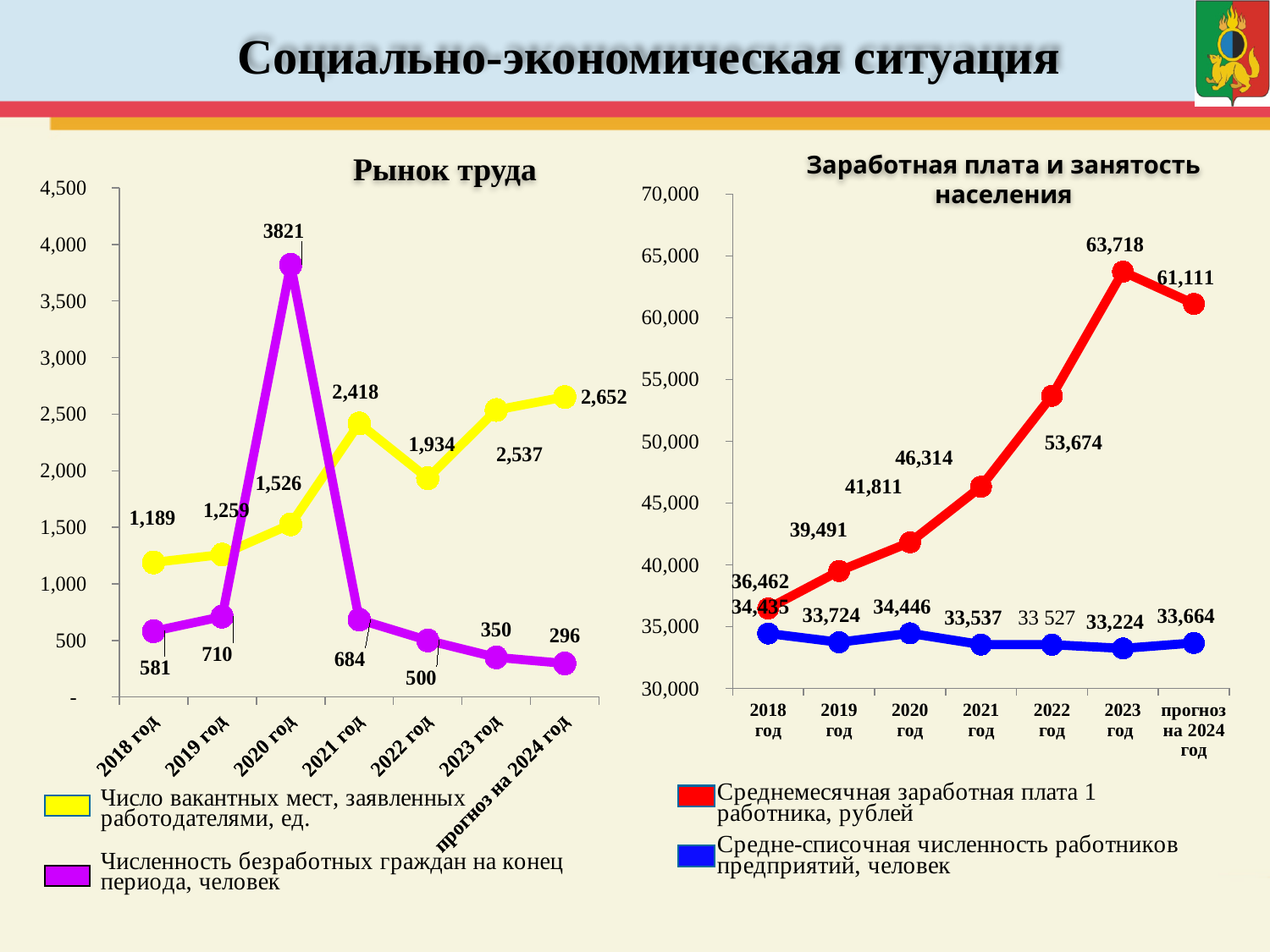
In the 'Рынок труда' chart, which category has the lowest value for the yellow series (Число вакантных мест)? 2018 год How many categories are shown on the x axis of the 'Рынок труда' chart? 7 In the 'Рынок труда' chart, what is the value of the purple series (Численность безработных граждан) for 2020 год? 3821 In the 'Заработная плата и занятость населения' chart, what is the value of the blue series (Средне-списочная численность работников) for 2019 год? 33,724 In the 'Заработная плата и занятость населения' chart, which is larger: the red series value for 2022 год or for 2021 год? 2022 год In the 'Рынок труда' chart, what is the number of vacant positions (yellow series) for прогноз на 2024 год? 2,652 In the 'Заработная плата и занятость населения' chart, what is the difference between the red series values for 2023 год and прогноз на 2024 год? 2,607 In the 'Рынок труда' chart, in which year does the purple series (Численность безработных граждан) reach its highest value? 2020 год In the 'Заработная плата и занятость населения' chart, what is the average monthly salary (red series) for 2023 год? 63,718 What type of chart is 'Рынок труда'? Line chart How many series does the legend of the 'Заработная плата и занятость населения' chart list? 2 In the 'Рынок труда' chart, what is the difference between the yellow series values for 2021 год and 2022 год? 484